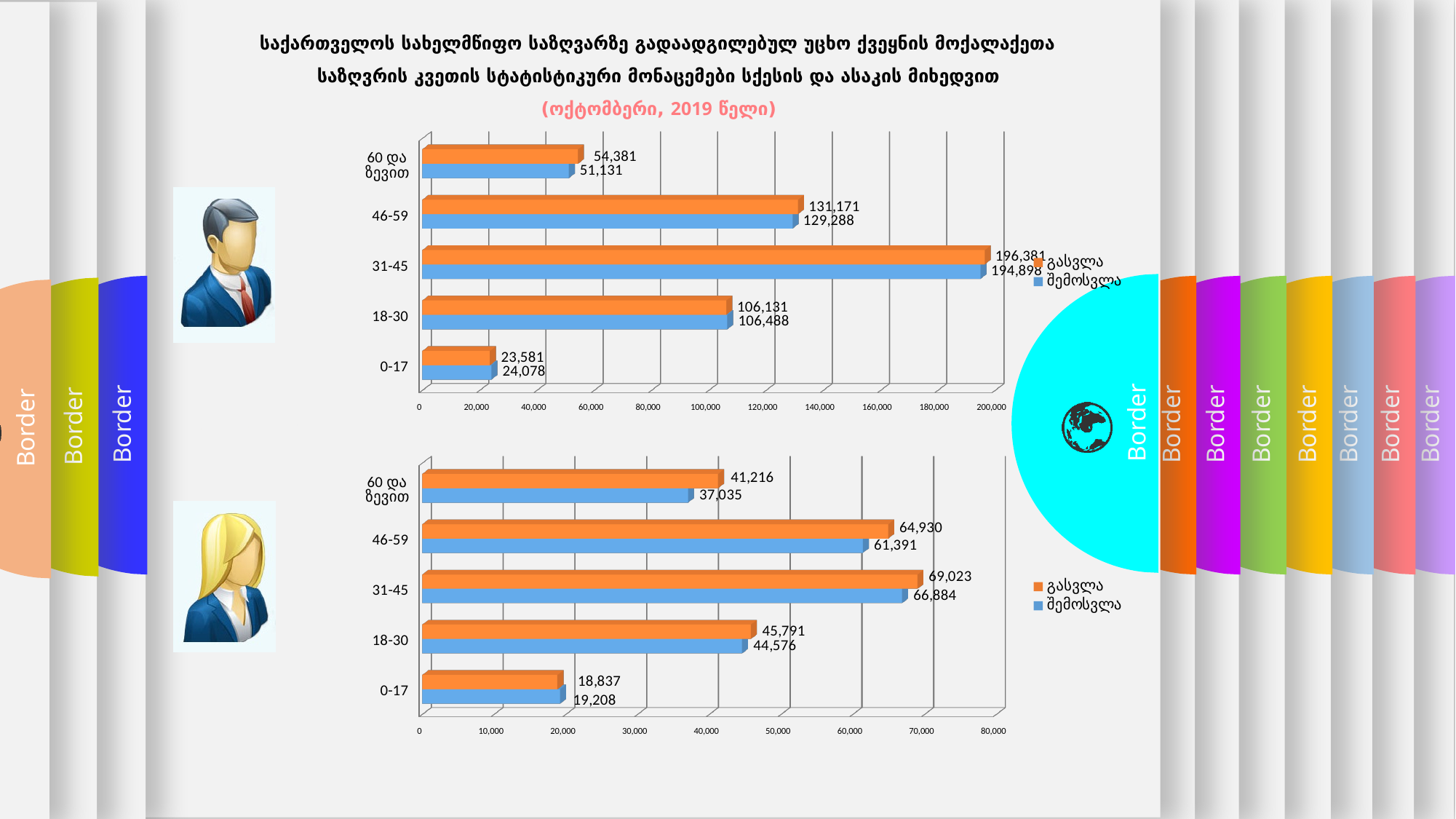
In the top chart, what is the შემოსვლა value for the 0-17 age group? 24,078 In the bottom chart, what is the difference between the გასვლა and შემოსვლა values for the 60 და ზევით age group? 4,181 In the bottom chart, which age group has the lowest შემოსვლა value? 0-17 In the top chart, which age group has the highest გასვლა value? 31-45 How many series does the legend of the top chart list? 2 In the bottom chart, what is the შემოსვლა value for the 60 და ზევით age group? 37,035 In the top chart, what is the difference between the გასვლა and შემოსვლა values for the 46-59 age group? 1,883 What type of chart is the bottom chart? Bar chart In the top chart, which is larger for the 18-30 age group, გასვლა or შემოსვლა? შემოსვლა In the bottom chart, what is the გასვლა value for the 46-59 age group? 64,930 In the top chart, what is the გასვლა value for the 31-45 age group? 196,381 How many age groups are shown in the bottom chart? 5